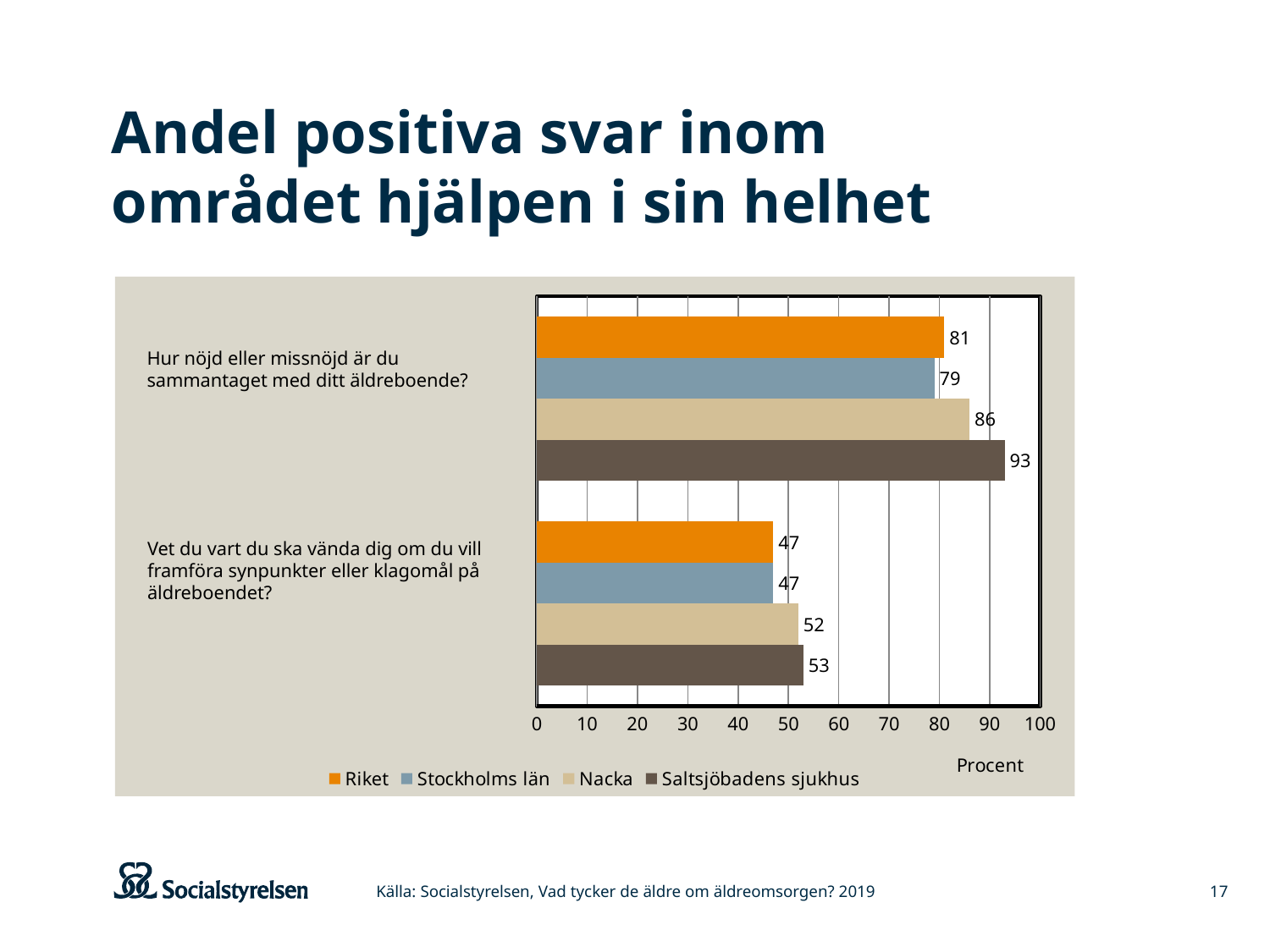
Which series has the highest value for the question "Hur nöjd eller missnöjd är du sammantaget med ditt äldreboende?"? Saltsjöbadens sjukhus What kind of chart is shown on the slide? bar chart For the question "Vet du vart du ska vända dig om du vill framföra synpunkter eller klagomål på äldreboendet?", which is larger: the value for Nacka or the value for Stockholms län? Nacka What is the difference between the Saltsjöbadens sjukhus value and the Riket value for the question "Hur nöjd eller missnöjd är du sammantaget med ditt äldreboende?"? 12 How many series does the legend list? 4 What value does Riket have for the question "Vet du vart du ska vända dig om du vill framföra synpunkter eller klagomål på äldreboendet?"? 47 How many questions (categories) are shown on the chart? 2 What is the label on the horizontal axis of the chart? Procent Which series has the lowest value for the question "Hur nöjd eller missnöjd är du sammantaget med ditt äldreboende?"? Stockholms län What value does Nacka have for the question "Hur nöjd eller missnöjd är du sammantaget med ditt äldreboende?"? 86 What value does Saltsjöbadens sjukhus have for the question "Hur nöjd eller missnöjd är du sammantaget med ditt äldreboende?"? 93 Is the value for Saltsjöbadens sjukhus on the question "Vet du vart du ska vända dig om du vill framföra synpunkter eller klagomål på äldreboendet?" greater or less than 60? less